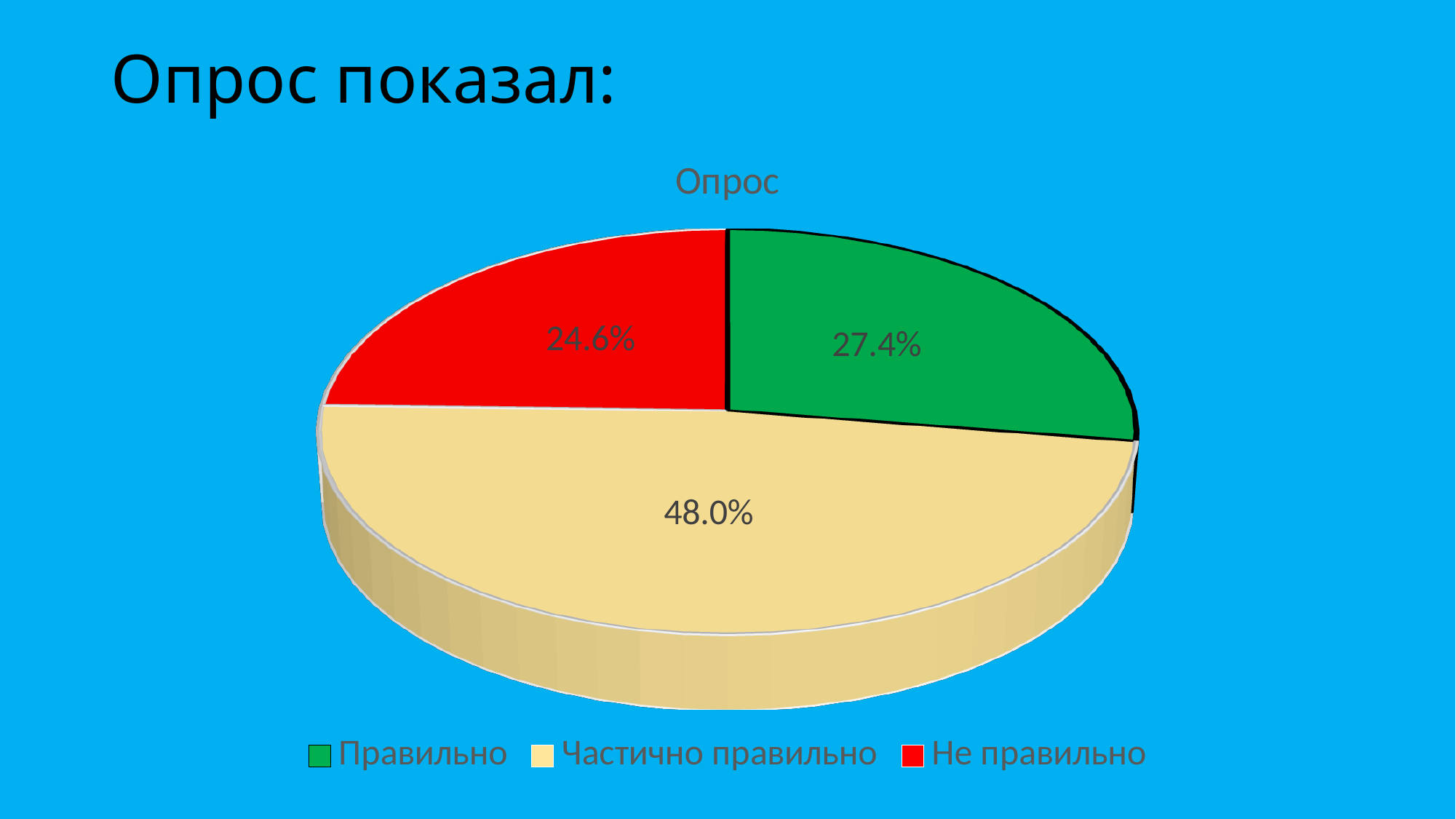
Which category has the largest slice of the pie? Частично правильно What is the title of the chart? Опрос What colour is the slice for Не правильно? Red Which is larger, the share for Правильно or the share for Не правильно? Правильно How many categories does the pie chart show? 3 What is the difference in percentage points between Правильно and Не правильно? 2.8 What share of the pie does Не правильно have? 24.6% What share of the pie does Частично правильно have? 48.0% What share of the pie does Правильно have? 27.4% What is the difference in percentage points between Частично правильно and Правильно? 20.6 Which category has the smallest slice of the pie? Не правильно What type of chart is shown on the slide? Pie chart